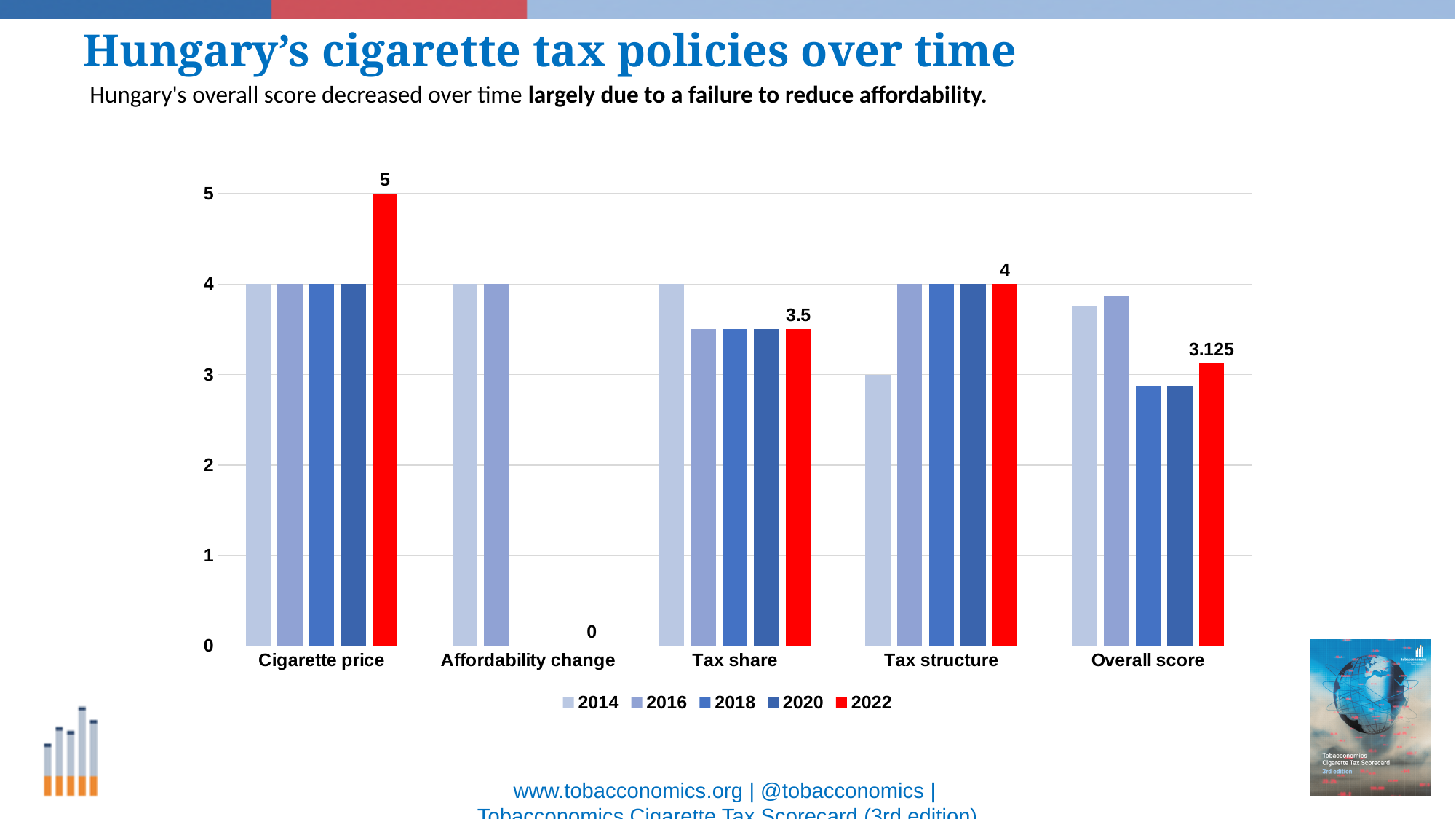
What is the value for Tax structure in 2014? 3 Which is larger in 2022: Tax structure or Tax share? Tax structure What is the value for Affordability change in 2022? 0 How many series does the legend list? 5 What is the Overall score for 2022? 3.125 Which category has the highest value for 2022? Cigarette price Is the Overall score for 2014 greater or less than 3? greater What kind of chart is shown on the slide? bar chart What is the value for Tax share in 2022? 3.5 What is the difference between the 2022 Cigarette price value and the 2022 Overall score? 1.875 Which category has the lowest value for 2022? Affordability change What is the value for Cigarette price in 2022? 5